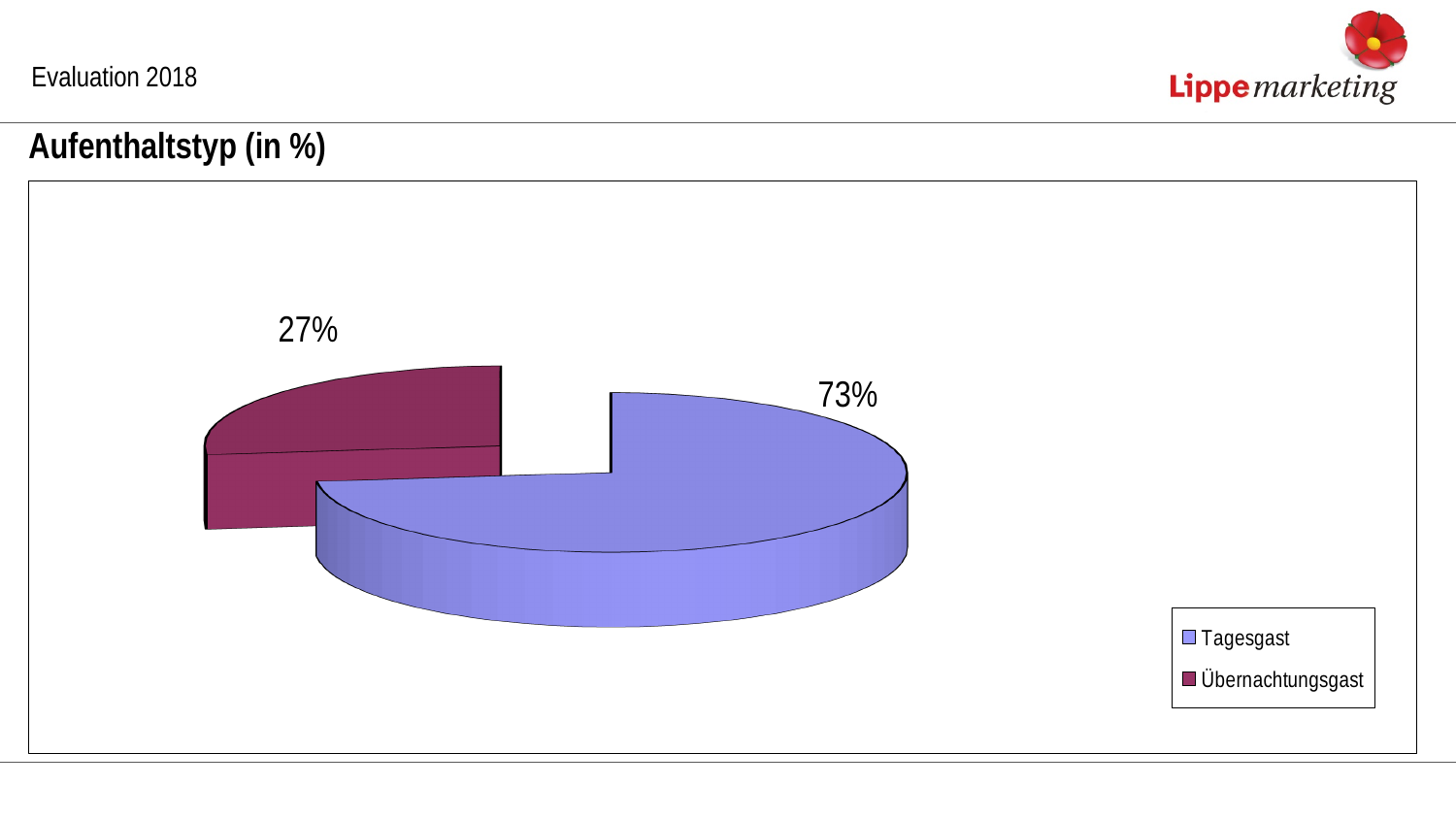
How many entries does the legend list? 2 What share of the pie does Übernachtungsgast have? 27% Which category has the largest slice of the pie? Tagesgast Which category has the smallest slice of the pie? Übernachtungsgast What is the difference in percentage points between Tagesgast and Übernachtungsgast? 46 What kind of chart is shown on the slide? Pie chart How many slices does the pie chart have? 2 What share of the pie does Tagesgast have? 73% Which is larger, the share for Tagesgast or for Übernachtungsgast? Tagesgast What colour is the Übernachtungsgast slice? Dark red What is the title of the chart? Aufenthaltstyp (in %)